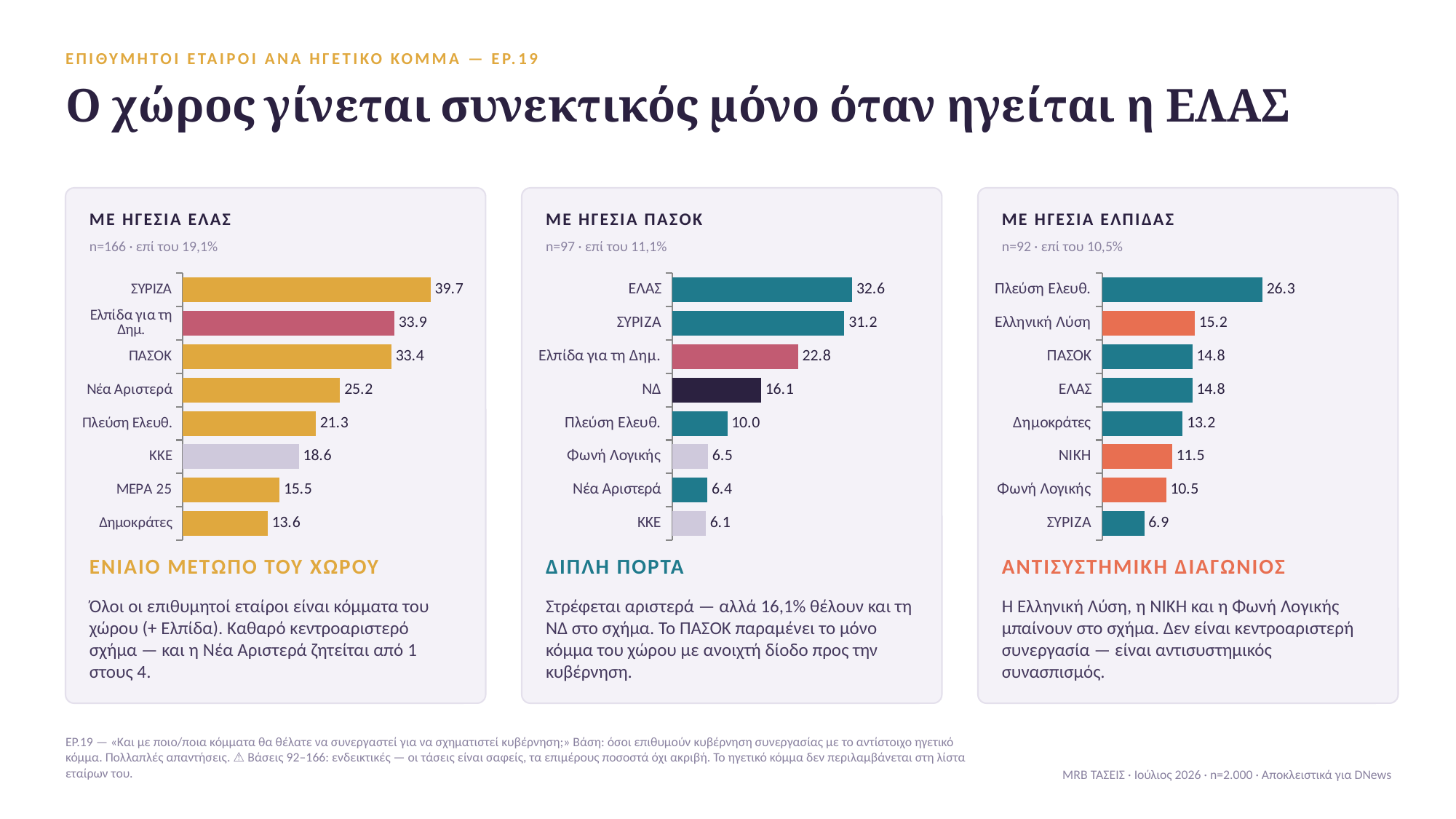
In the chart titled ΜΕ ΗΓΕΣΙΑ ΕΛΑΣ, what is the value for ΣΥΡΙΖΑ? 39.7 In the chart titled ΜΕ ΗΓΕΣΙΑ ΠΑΣΟΚ, which is larger, the value for Ελπίδα για τη Δημ. or the value for Πλεύση Ελευθ.? Ελπίδα για τη Δημ. In the chart titled ΜΕ ΗΓΕΣΙΑ ΕΛΑΣ, what is the difference between the values for ΣΥΡΙΖΑ and ΠΑΣΟΚ? 6.3 In the chart titled ΜΕ ΗΓΕΣΙΑ ΠΑΣΟΚ, what is the value for ΝΔ? 16.1 In the chart titled ΜΕ ΗΓΕΣΙΑ ΕΛΑΣ, which category has the lowest value? Δημοκράτες In the chart titled ΜΕ ΗΓΕΣΙΑ ΕΛΠΙΔΑΣ, which category has the highest value? Πλεύση Ελευθ. In the chart titled ΜΕ ΗΓΕΣΙΑ ΠΑΣΟΚ, what is the difference between the values for ΕΛΑΣ and ΣΥΡΙΖΑ? 1.4 In the chart titled ΜΕ ΗΓΕΣΙΑ ΕΛΠΙΔΑΣ, what is the value for Ελληνική Λύση? 15.2 In the chart titled ΜΕ ΗΓΕΣΙΑ ΕΛΑΣ, how many categories are shown? 8 What kind of chart is the chart titled ΜΕ ΗΓΕΣΙΑ ΕΛΠΙΔΑΣ? Bar chart In the chart titled ΜΕ ΗΓΕΣΙΑ ΕΛΠΙΔΑΣ, what is the difference between the values for ΝΙΚΗ and ΣΥΡΙΖΑ? 4.6 In the chart titled ΜΕ ΗΓΕΣΙΑ ΠΑΣΟΚ, which category has the highest value? ΕΛΑΣ